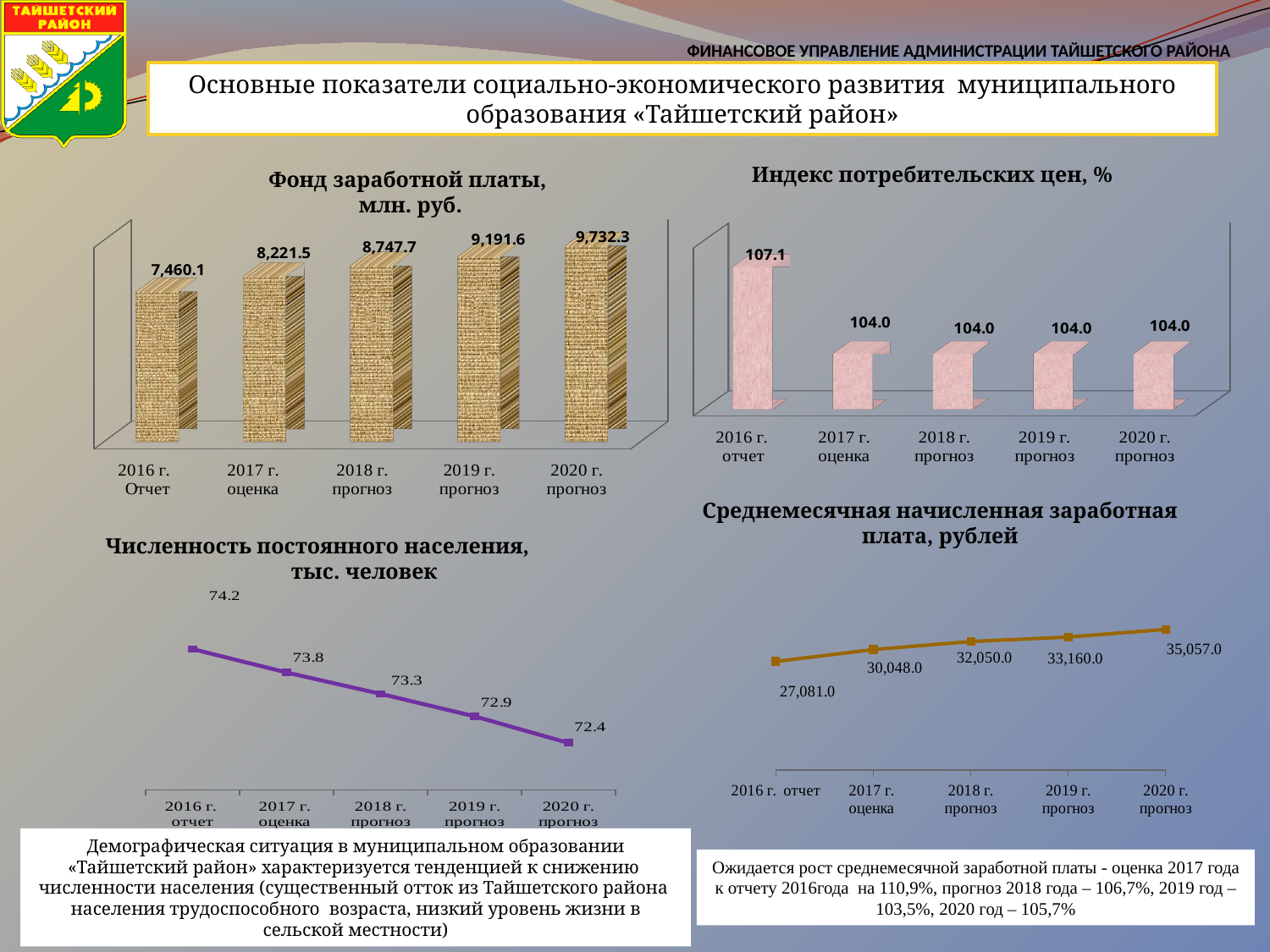
In the chart "Индекс потребительских цен, %", what is the value for 2016 г. отчет? 107.1 In the chart "Индекс потребительских цен, %", what is the difference between the 2016 г. отчет value and the 2017 г. оценка value? 3.1 In the chart "Численность постоянного населения, тыс. человек", do the values rise or fall from 2016 to 2020? fall In the chart "Среднемесячная начисленная заработная плата, рублей", what is the difference between the 2020 г. прогноз value and the 2016 г. отчет value? 7,976.0 In the chart "Индекс потребительских цен, %", how many years are shown on the x axis? 5 In the chart "Среднемесячная начисленная заработная плата, рублей", which year has the highest value? 2020 г. прогноз In the chart "Фонд заработной платы, млн. руб.", what is the value for 2020 г. прогноз? 9,732.3 In the chart "Фонд заработной платы, млн. руб.", what is the difference between the 2020 г. прогноз value and the 2016 г. Отчет value? 2,272.2 In the chart "Среднемесячная начисленная заработная плата, рублей", what is the value for 2017 г. оценка? 30,048.0 What kind of chart is "Численность постоянного населения, тыс. человек"? line chart In the chart "Фонд заработной платы, млн. руб.", which year has the lowest value? 2016 г. Отчет In the chart "Численность постоянного населения, тыс. человек", what is the value for 2018 г. прогноз? 73.3